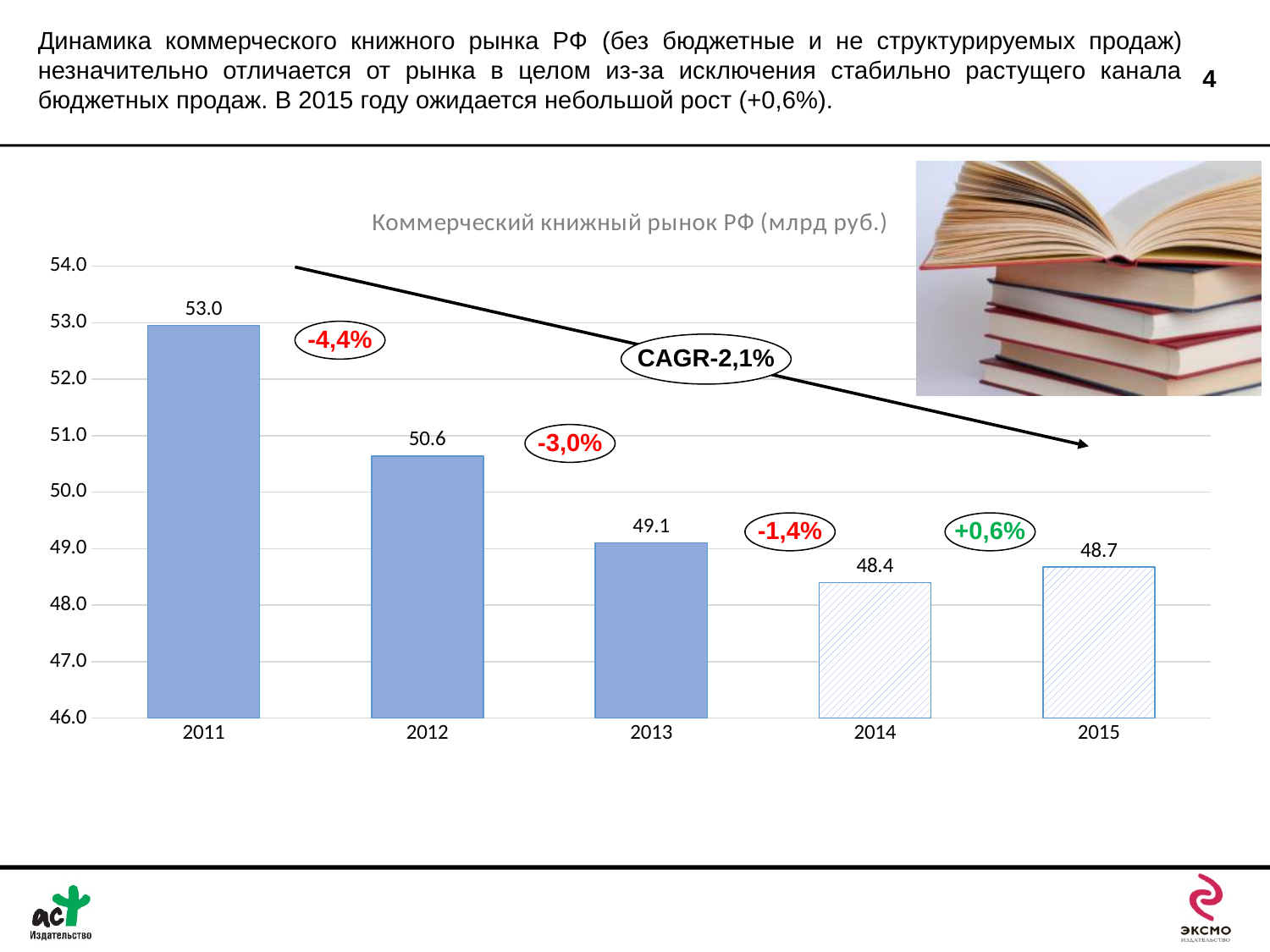
What is the value for 2011? 53.0 What is the difference between the values for 2011 and 2013? 3.9 Which year has the highest value? 2011 What is the value for 2014? 48.4 What is the value for 2015? 48.7 How many years are shown on the x axis? 5 What is the title of the chart? Коммерческий книжный рынок РФ (млрд руб.) Which year has the lowest value? 2014 What kind of chart is shown? bar chart Is the value for 2013 greater or less than 50.0? less What is the difference between the values for 2012 and 2014? 2.2 Which is larger, the value for 2012 or the value for 2013? 2012